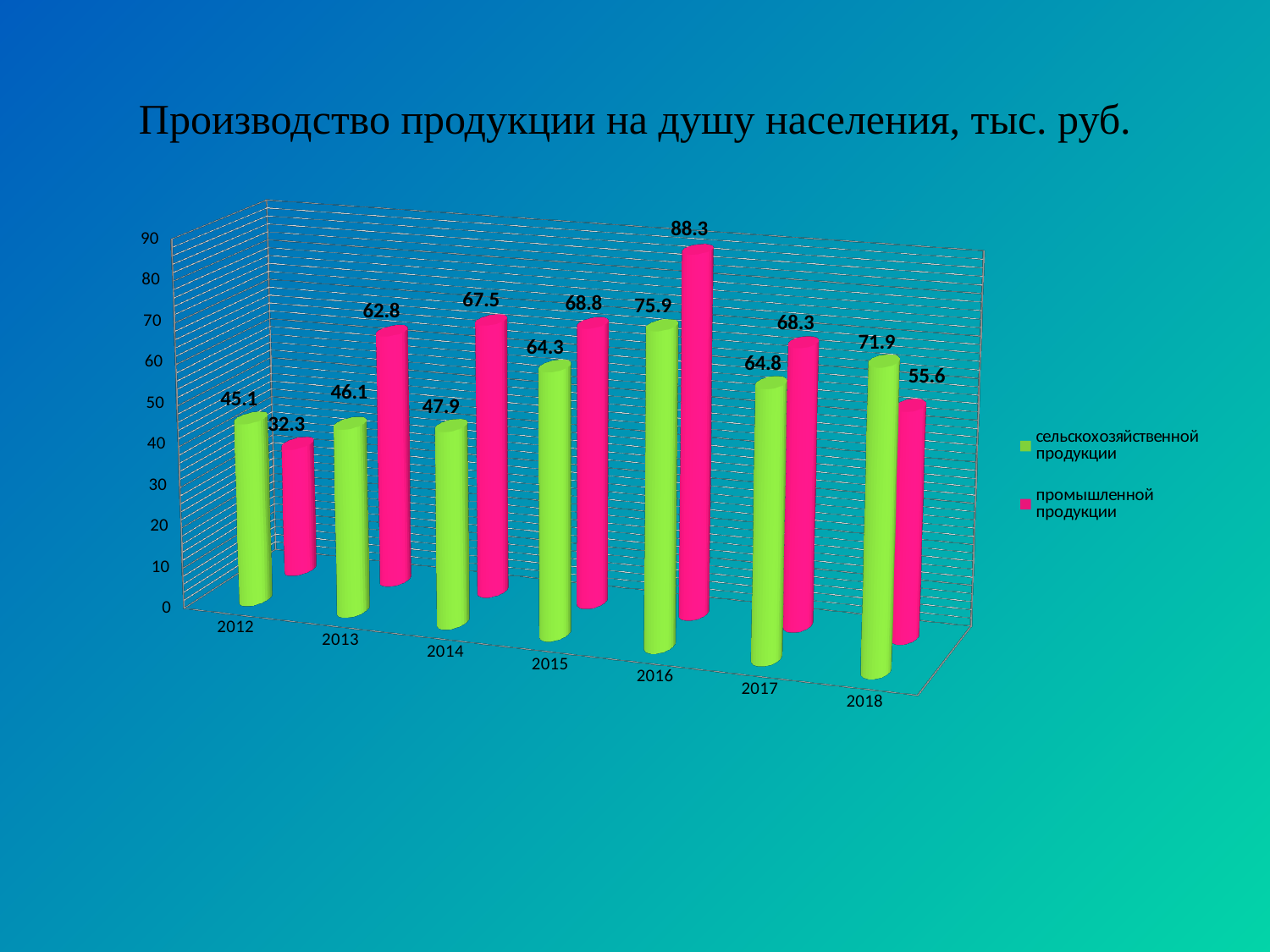
In which year is the value for сельскохозяйственной продукции lowest? 2012 What is the value for промышленной продукции in 2018? 55.6 What is the value for сельскохозяйственной продукции in 2016? 75.9 What is the value for промышленной продукции in 2012? 32.3 How many years are shown on the x axis? 7 How many series does the legend list? 2 What kind of chart is shown on the slide? bar chart Which is larger in 2018: сельскохозяйственной продукции or промышленной продукции? сельскохозяйственной продукции What is the difference between промышленной продукции and сельскохозяйственной продукции in 2016? 12.4 In which year is the value for промышленной продукции highest? 2016 Is the value for промышленной продукции in 2013 greater or less than 50? greater What is the title of the chart? Производство продукции на душу населения, тыс. руб.